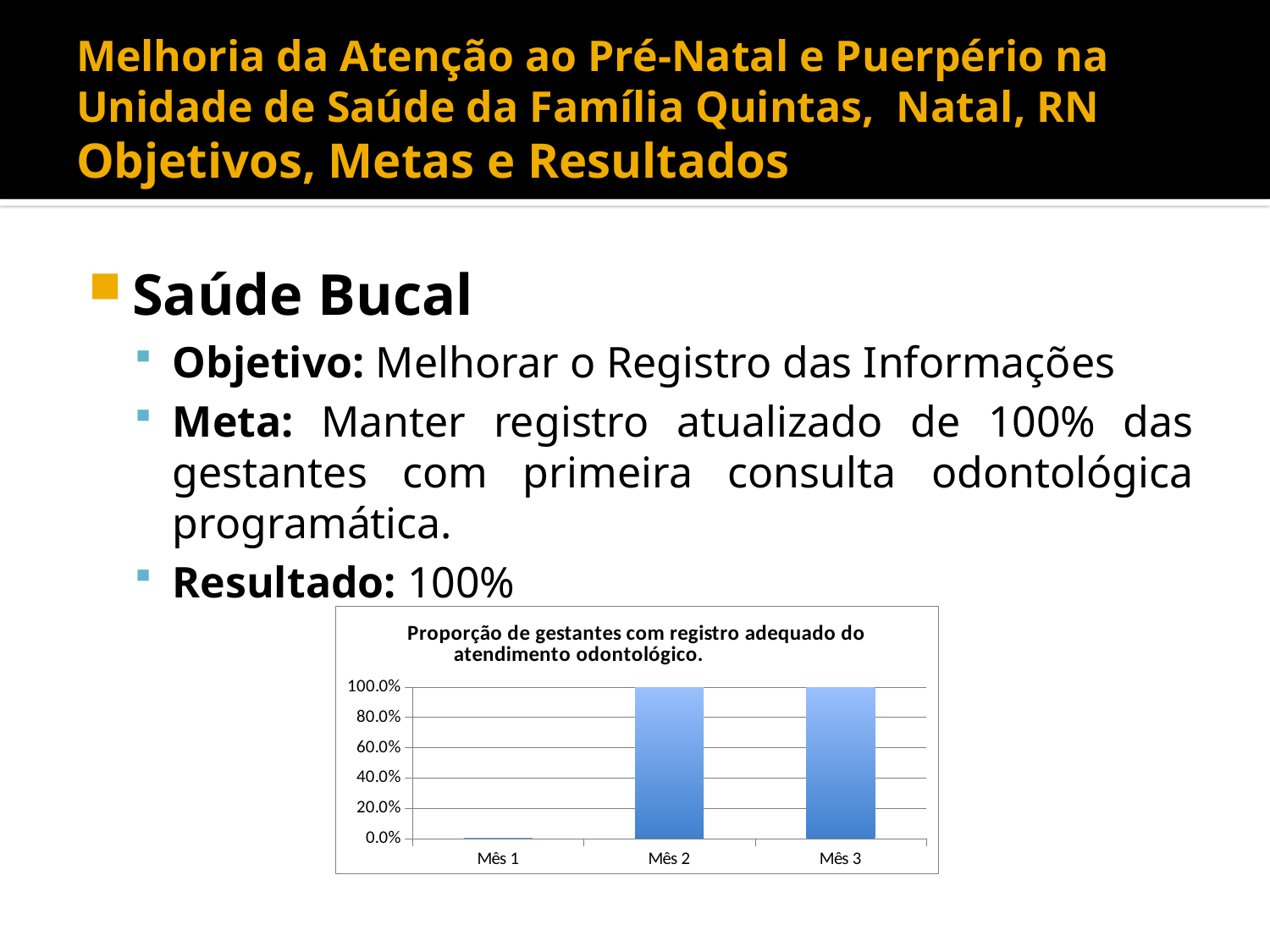
How many categories are shown on the x axis of the chart? 3 What is the highest value shown on the y axis of the chart? 100.0% Which is larger, the value for Mês 1 or the value for Mês 2? Mês 2 Which is larger, the value for Mês 3 or the value for Mês 1? Mês 3 Is the value for Mês 2 greater or less than 80.0%? greater What is the value for Mês 2? 100.0% Is the value for Mês 1 greater or less than 20.0%? less What is the title of the chart? Proporção de gestantes com registro adequado do atendimento odontológico. Which month has the lowest value? Mês 1 Do the values rise or fall from Mês 1 to Mês 3? rise What is the value for Mês 3? 100.0% What kind of chart is shown on the slide? bar chart